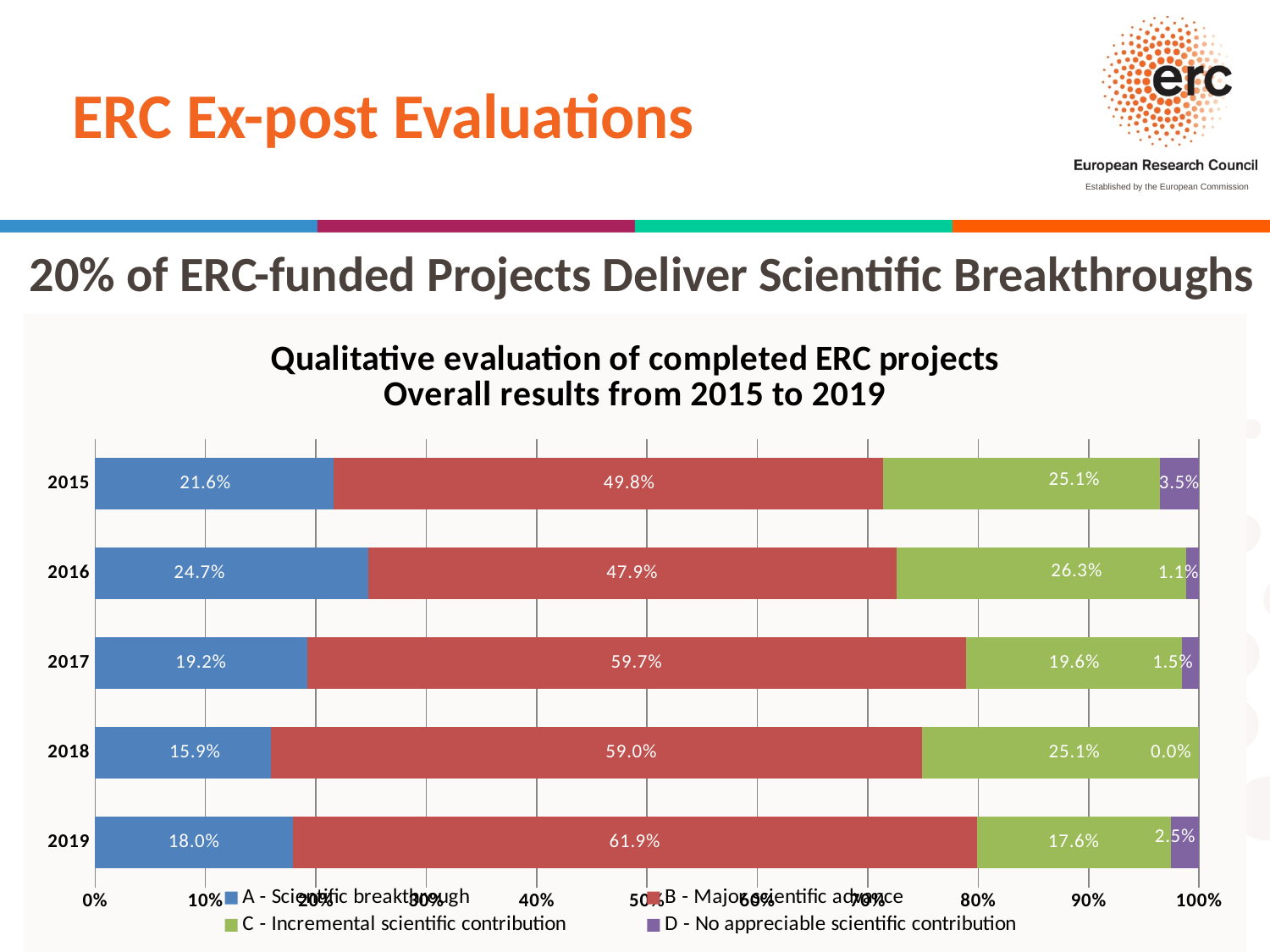
Which year has the lowest value for B - Major scientific advance? 2016 What is the value for D - No appreciable scientific contribution in 2018? 0.0% What is the difference between the B - Major scientific advance values for 2019 and 2015? 12.1% What is the title of the chart? Qualitative evaluation of completed ERC projects Overall results from 2015 to 2019 Which is larger, the A - Scientific breakthrough value for 2015 or for 2018? 2015 What is the value for B - Major scientific advance in 2019? 61.9% How many years are shown on the chart? 5 What is the value for C - Incremental scientific contribution in 2017? 19.6% What is the value for A - Scientific breakthrough in 2016? 24.7% What kind of chart is shown on the slide? Stacked bar chart How many series does the legend list? 4 Which year has the highest value for A - Scientific breakthrough? 2016